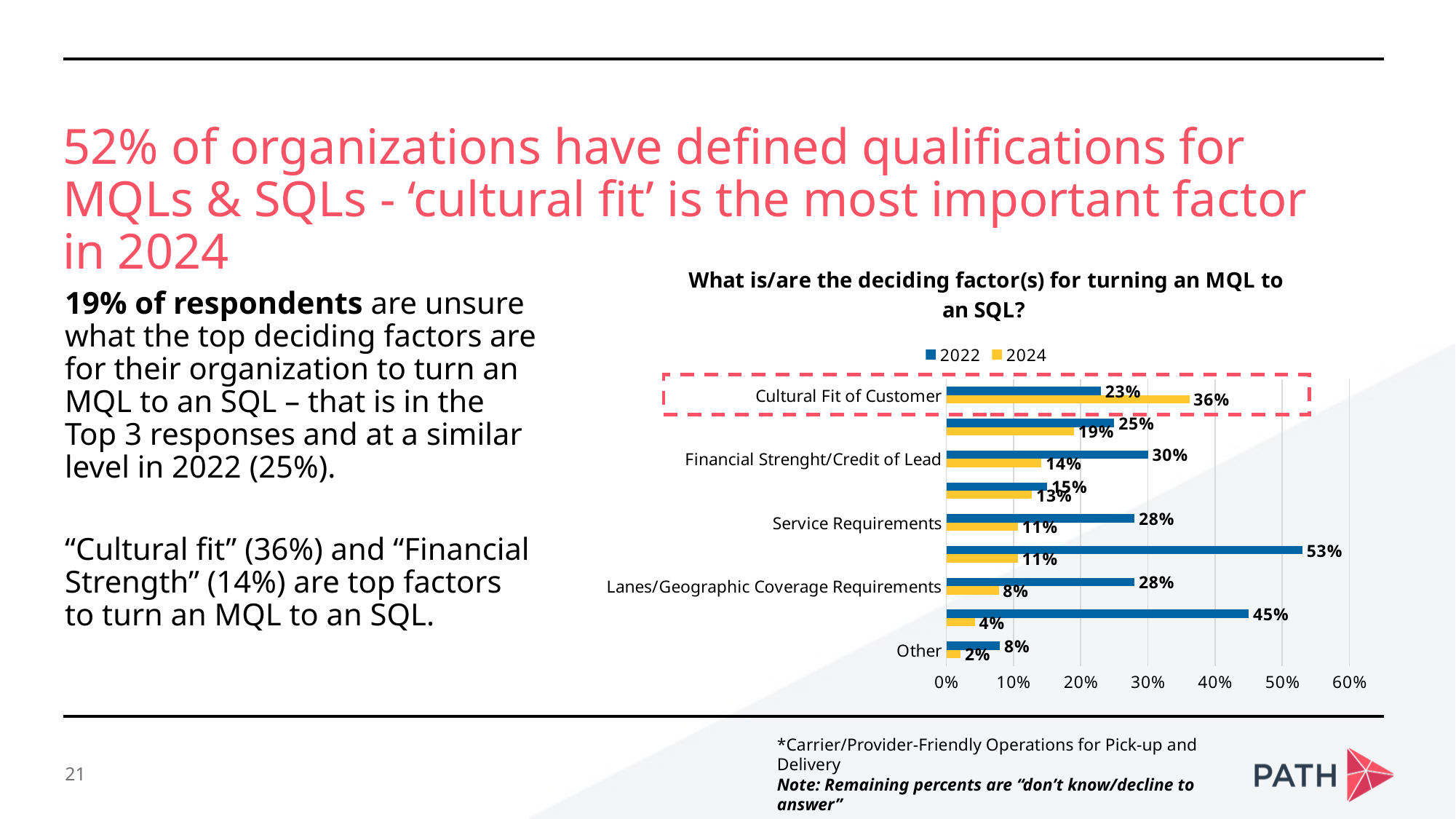
How many series does the chart legend list? 2 Which two series are listed in the chart legend? 2022 and 2024 What is the 2022 value for Other? 8% Which labeled category has the highest 2024 value? Cultural Fit of Customer What is the 2024 value for Cultural Fit of Customer? 36% By how many percentage points did Cultural Fit of Customer increase from 2022 to 2024? 13 percentage points What is the 2024 value for Financial Strenght/Credit of Lead? 14% Which labeled category has the lowest 2024 value? Other What is the 2022 value for Cultural Fit of Customer? 23% For Financial Strenght/Credit of Lead, which year has the larger value, 2022 or 2024? 2022 What is the 2022 value for Service Requirements? 28% What kind of chart is shown on the slide? Bar chart